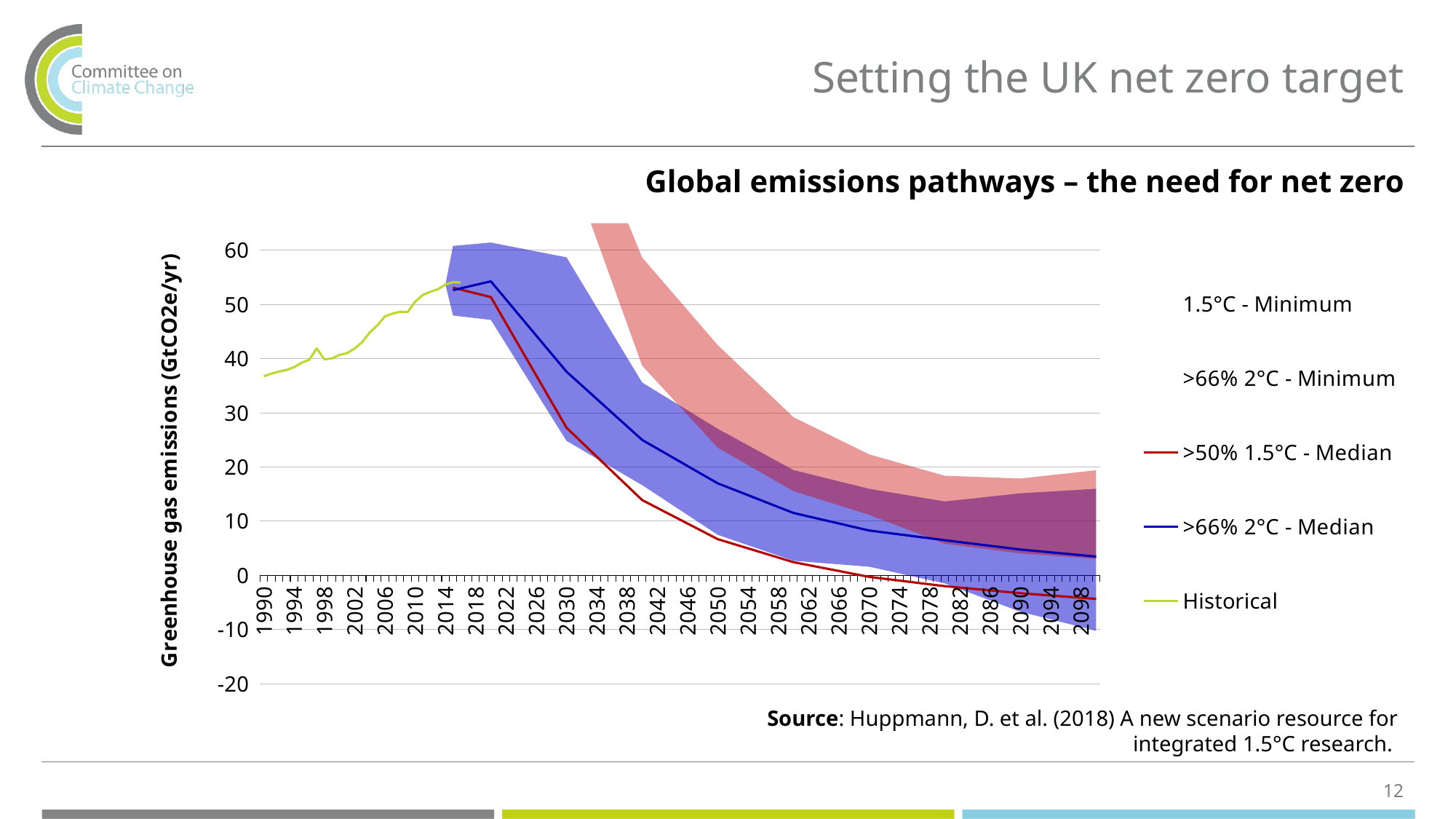
Is the Historical value in 1990 greater or less than 30? greater Is the >66% 2°C - Median value in 2050 greater or less than 10? greater What kind of chart is shown on the slide? combination area and line chart What is the label on the vertical axis of the chart? Greenhouse gas emissions (GtCO2e/yr) Is the >50% 1.5°C - Median value in 2098 greater or less than 0? less What is the title of the chart? Global emissions pathways – the need for net zero In 2050, which is higher: the >50% 1.5°C - Median or the >66% 2°C - Median? >66% 2°C - Median In 2030, which is higher: the >50% 1.5°C - Median or the >66% 2°C - Median? >66% 2°C - Median Does the Historical series rise or fall between 1990 and 2014? rise Does the >66% 2°C - Median series rise or fall between 2022 and 2098? fall How many series does the legend list? 5